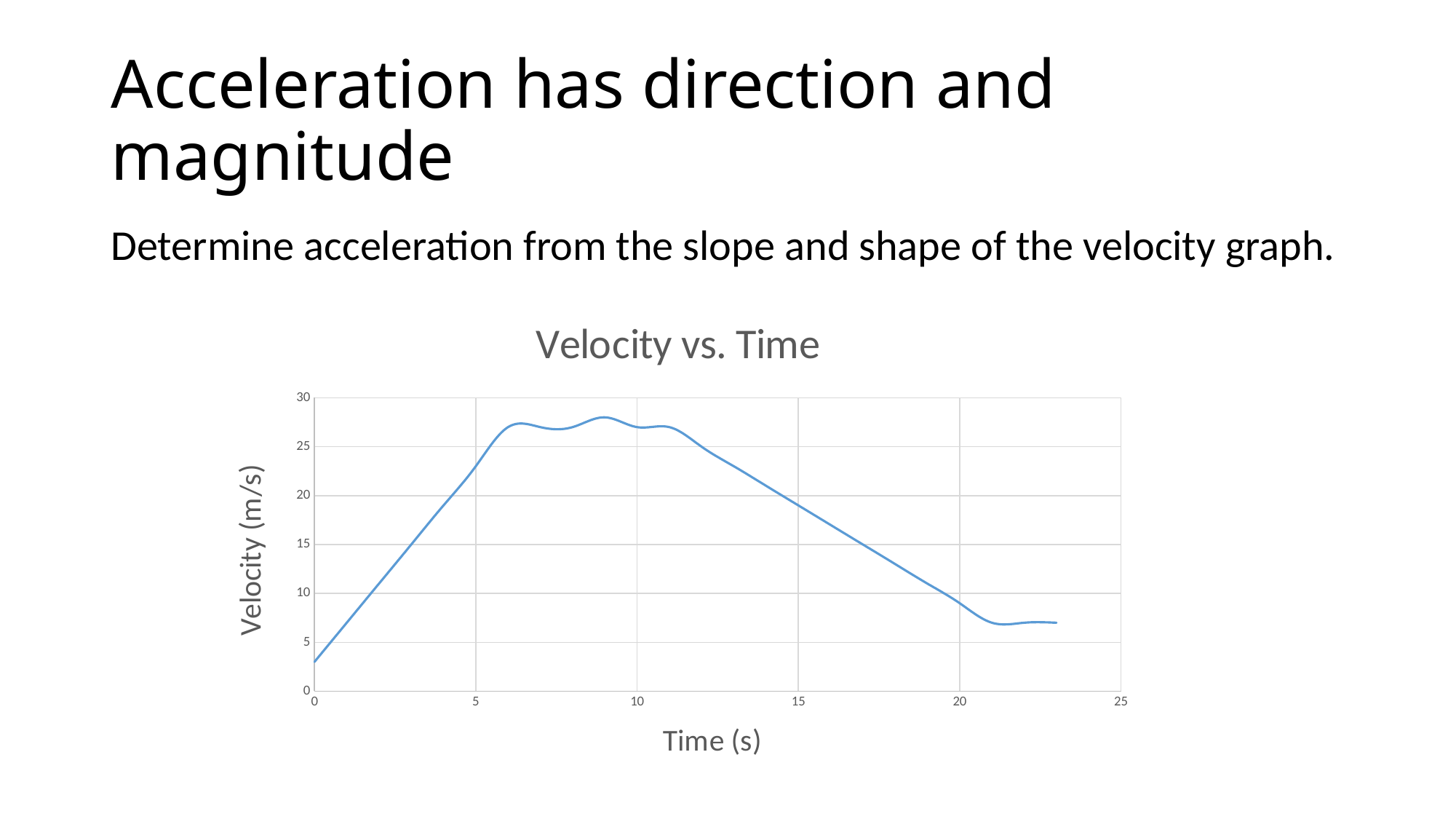
Is the velocity at the end of the graph (around 23 s) greater or less than 5 m/s? greater Is the velocity at the end of the graph (around 23 s) greater or less than 10 m/s? less What is the label of the vertical axis of the chart? Velocity (m/s) What is the title of the chart? Velocity vs. Time Does the velocity rise or fall between 12 s and 20 s? fall Is the velocity at 5 s greater or less than the velocity at 20 s? greater Does the velocity rise or fall between 0 s and 5 s? rise Is the highest velocity reached on the graph greater or less than 30 m/s? less What kind of chart is shown on the slide? line chart